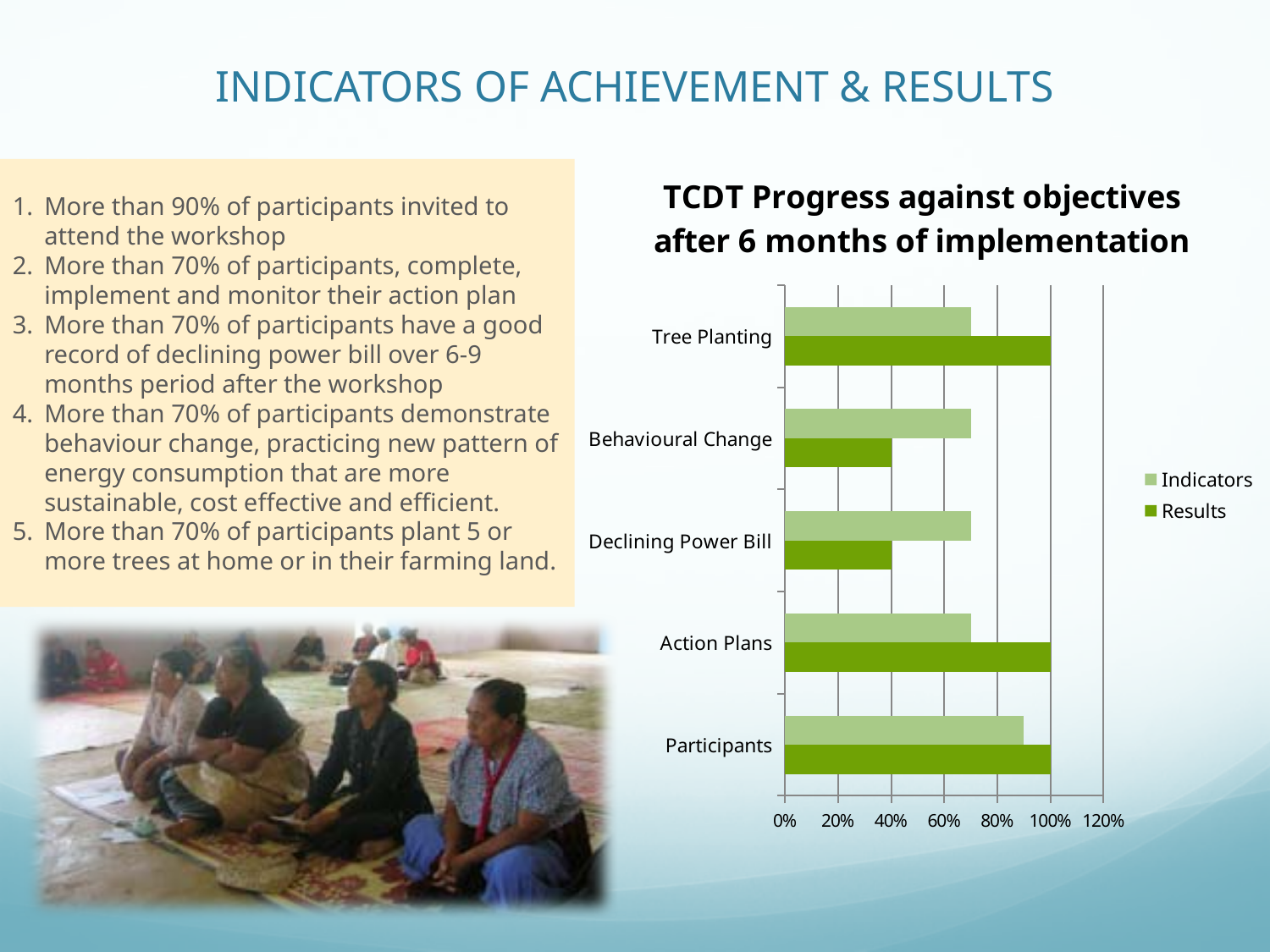
For Behavioural Change, which is larger: the Indicators value or the Results value? Indicators Is the Indicators value for Tree Planting greater or less than 60%? greater What is the Results value for Behavioural Change? 40% What is the Results value for Tree Planting? 100% Is the Indicators value for Participants greater or less than 80%? greater What kind of chart is shown on the slide? Bar chart How many series does the chart legend list? 2 What is the Results value for Action Plans? 100% Which category has the highest Indicators value? Participants What is the Results value for Declining Power Bill? 40% What is the title of the chart? TCDT Progress against objectives after 6 months of implementation How many categories are shown on the chart? 5